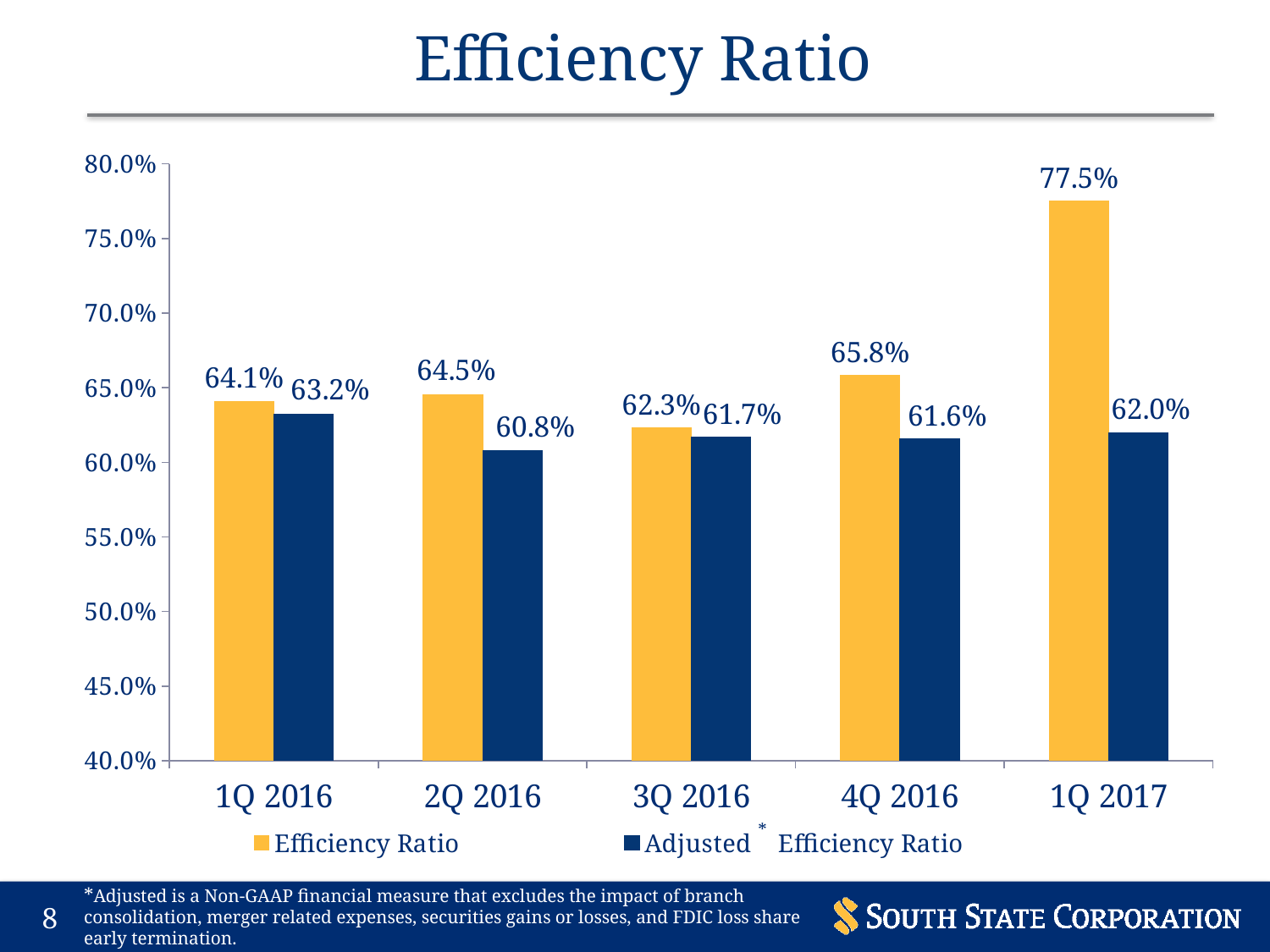
Which quarter has the highest Efficiency Ratio? 1Q 2017 How many quarters are shown on the x axis? 5 What is the Efficiency Ratio for 1Q 2017? 77.5% Which is larger in 4Q 2016, the Efficiency Ratio or the Adjusted Efficiency Ratio? Efficiency Ratio Which quarter has the lowest Adjusted Efficiency Ratio? 2Q 2016 How many series does the legend list? 2 What is the Efficiency Ratio for 3Q 2016? 62.3% What is the difference between the Efficiency Ratio and the Adjusted Efficiency Ratio in 1Q 2017? 15.5% What kind of chart is shown on the slide? Bar chart Is the Efficiency Ratio for 1Q 2017 greater or less than 75.0%? greater What is the Adjusted Efficiency Ratio for 2Q 2016? 60.8% What is the title of the chart? Efficiency Ratio